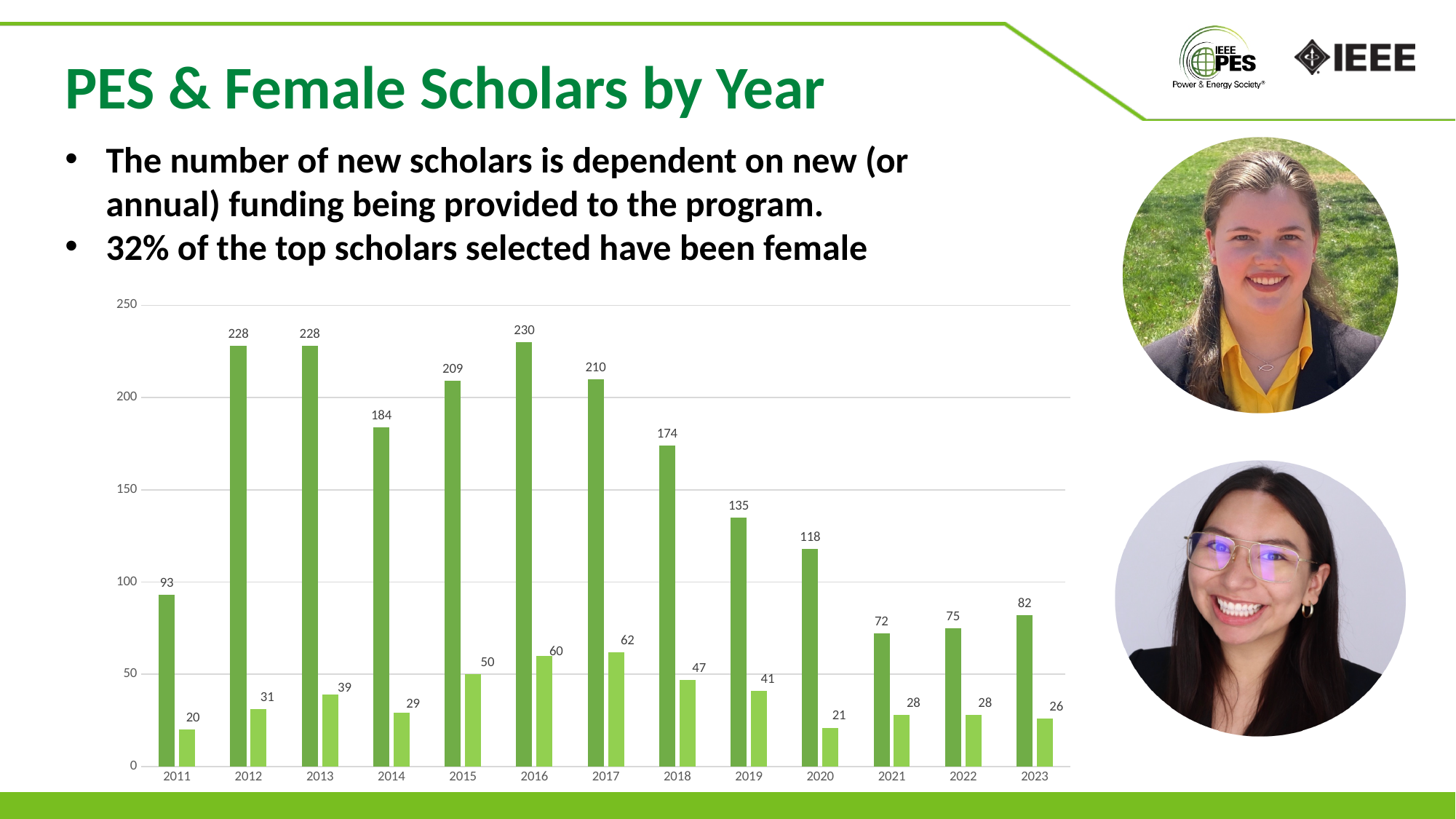
Is the value of the darker green bar for 2020 greater or less than 100? greater How many years are shown on the x axis of the chart? 13 Which year has the lowest darker green bar? 2021 Which year has the highest darker green bar? 2016 What is the value of the darker green bar for 2016? 230 Which year has the lowest lighter green bar? 2011 What is the difference between the darker green bar and the lighter green bar for 2018? 127 What kind of chart is shown on the slide? bar chart What is the value of the lighter green bar for 2017? 62 Do the darker green bars rise or fall from 2017 to 2021? fall Which is larger, the darker green bar for 2014 or the darker green bar for 2015? 2015 What is the value of the darker green bar for 2019? 135